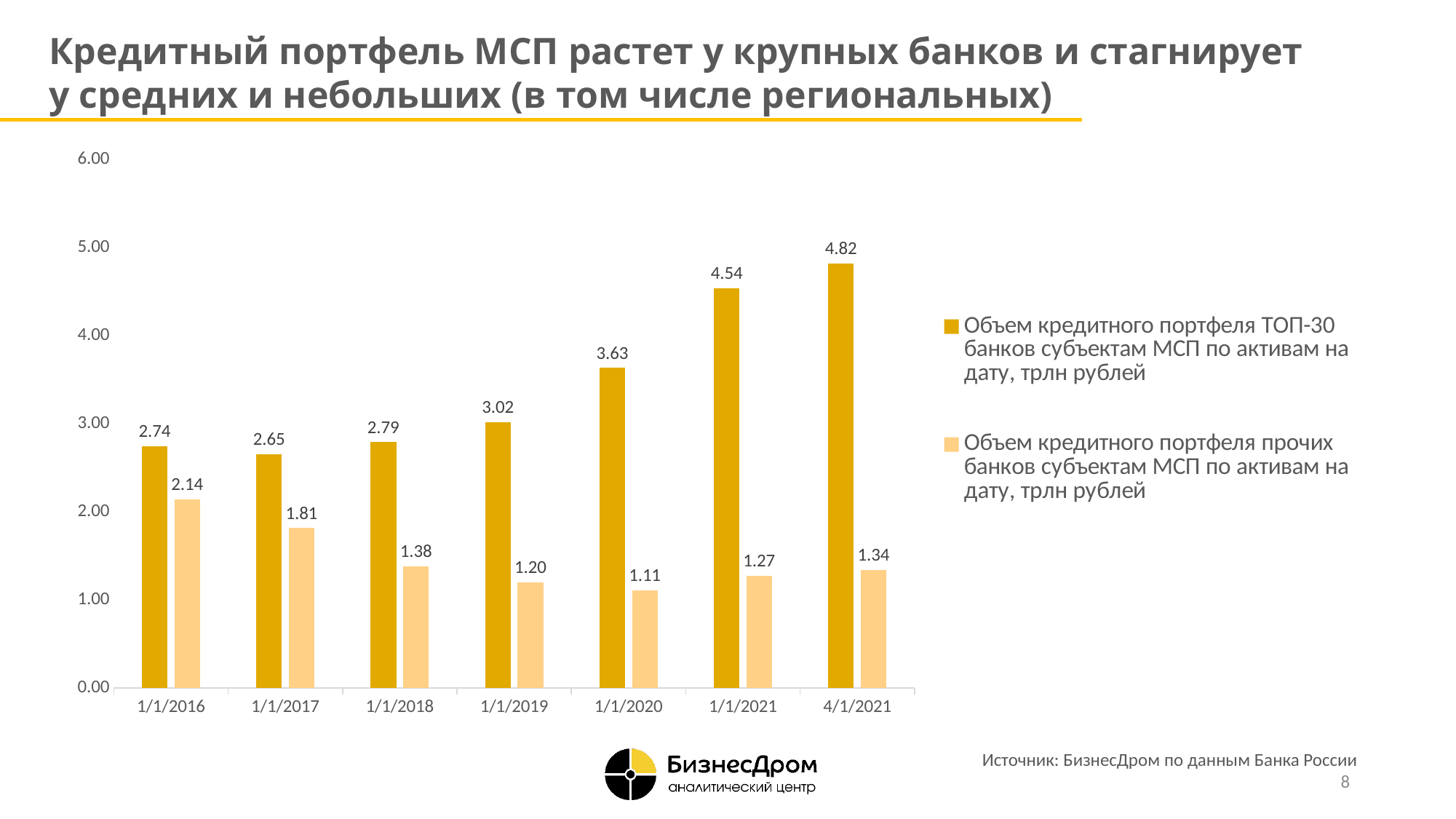
How many series does the legend list? 2 What is the difference between the TOP-30 banks' portfolio and the other banks' portfolio on 4/1/2021? 3.48 On which date is the other banks' SME loan portfolio the lowest? 1/1/2020 What kind of chart is shown on the slide? bar chart On which date is the TOP-30 banks' SME loan portfolio the highest? 4/1/2021 What is the value of the TOP-30 banks' SME loan portfolio (Объем кредитного портфеля ТОП-30 банков) on 1/1/2020? 3.63 Is the TOP-30 banks' portfolio on 1/1/2021 greater or less than 4.00? greater What is the value of the other banks' SME loan portfolio (Объем кредитного портфеля прочих банков) on 1/1/2017? 1.81 What is the combined value of the TOP-30 banks' and other banks' portfolios on 1/1/2016? 4.88 How many dates are shown on the x axis of the chart? 7 Does the TOP-30 banks' SME loan portfolio rise or fall from 1/1/2018 to 4/1/2021? rise Which is larger: the other banks' portfolio on 1/1/2016 or on 1/1/2021? 1/1/2016